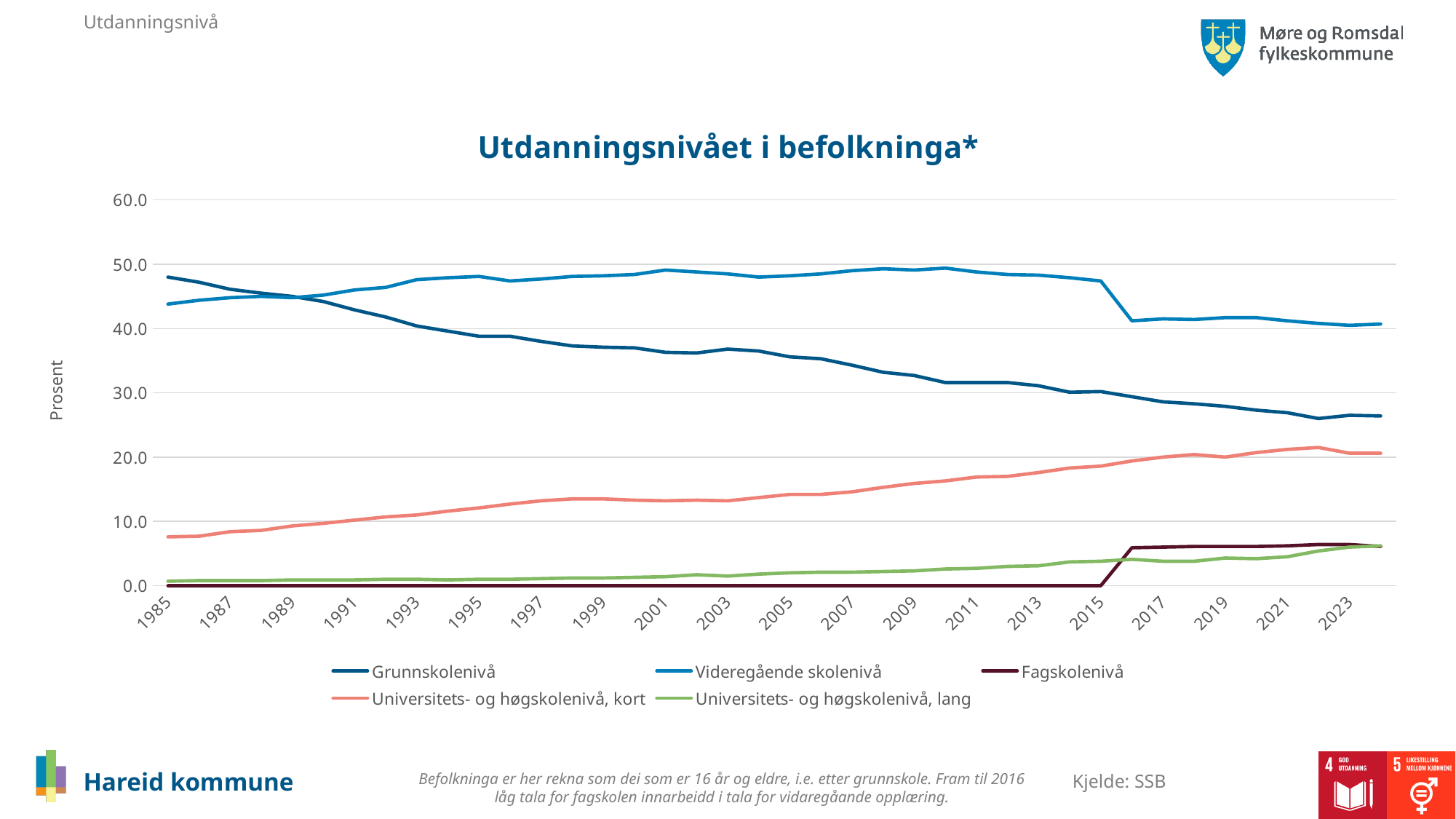
Is the value for Grunnskolenivå in 1985 greater or less than 40? greater Is the value for Grunnskolenivå in 2023 greater or less than 30? less Is the value for Fagskolenivå in 2017 greater or less than 5? greater What is the title of the chart? Utdanningsnivået i befolkninga* How many series does the legend list? 5 In 1985, which is larger: Grunnskolenivå or Videregående skolenivå? Grunnskolenivå Does the Grunnskolenivå line generally rise or fall from 1985 to 2023? Fall Which series has the highest value in 2023? Videregående skolenivå What is the label on the vertical axis? Prosent What kind of chart is shown on the slide? Line chart